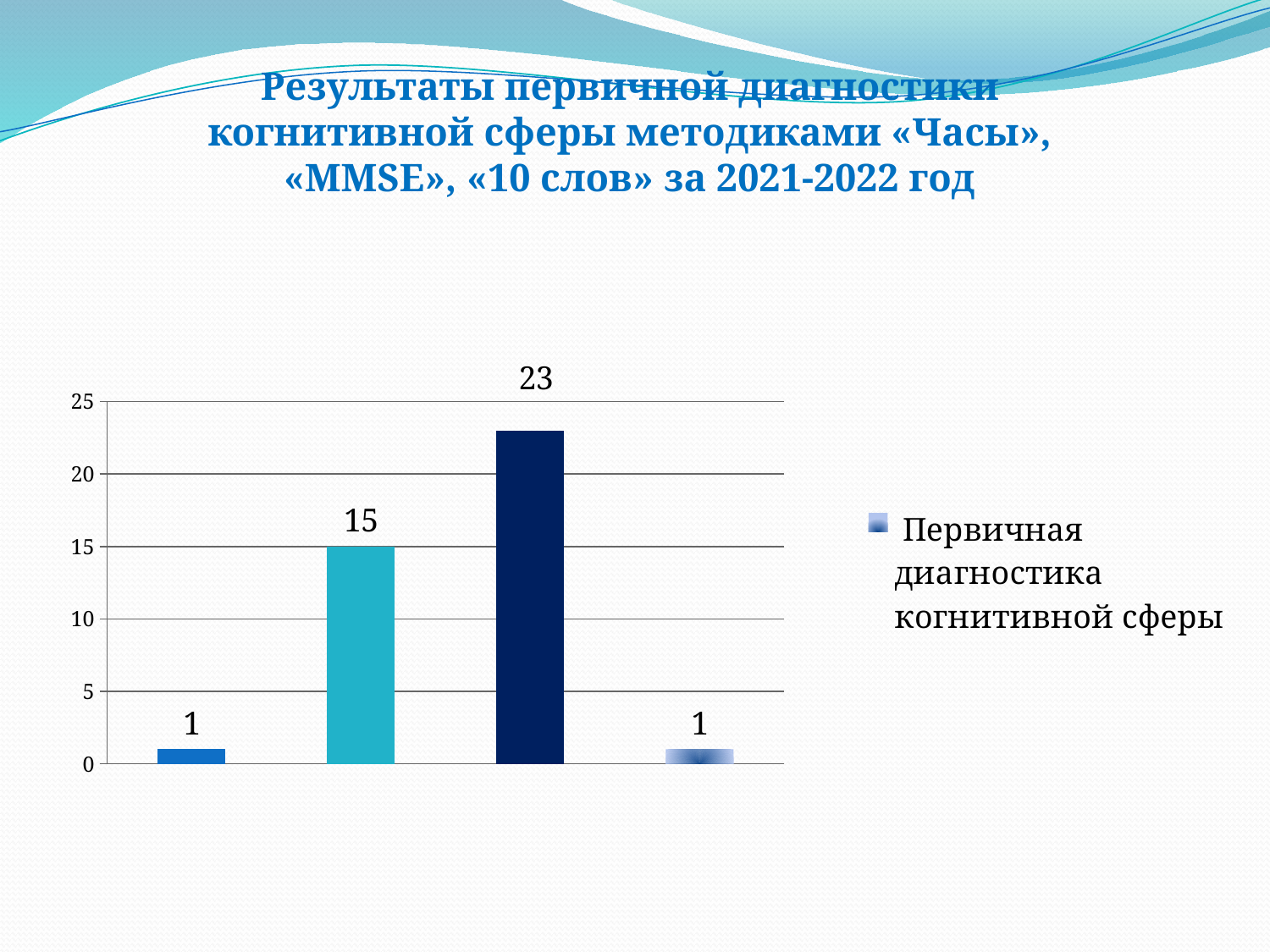
What is the value of the first bar from the left? 1 What type of chart is shown on the slide? bar chart Which is larger, the second bar or the third bar? the third bar Is the value of the third bar greater or less than 20? greater How many bars are plotted in the chart? 4 How many series does the legend list? 1 What is the highest value shown on the vertical axis? 25 What is the legend entry shown next to the chart? Первичная диагностика когнитивной сферы What is the value of the tallest bar in the chart? 23 What is the value of the second bar from the left? 15 What is the value of the fourth bar from the left? 1 What is the difference between the third bar (23) and the second bar (15)? 8